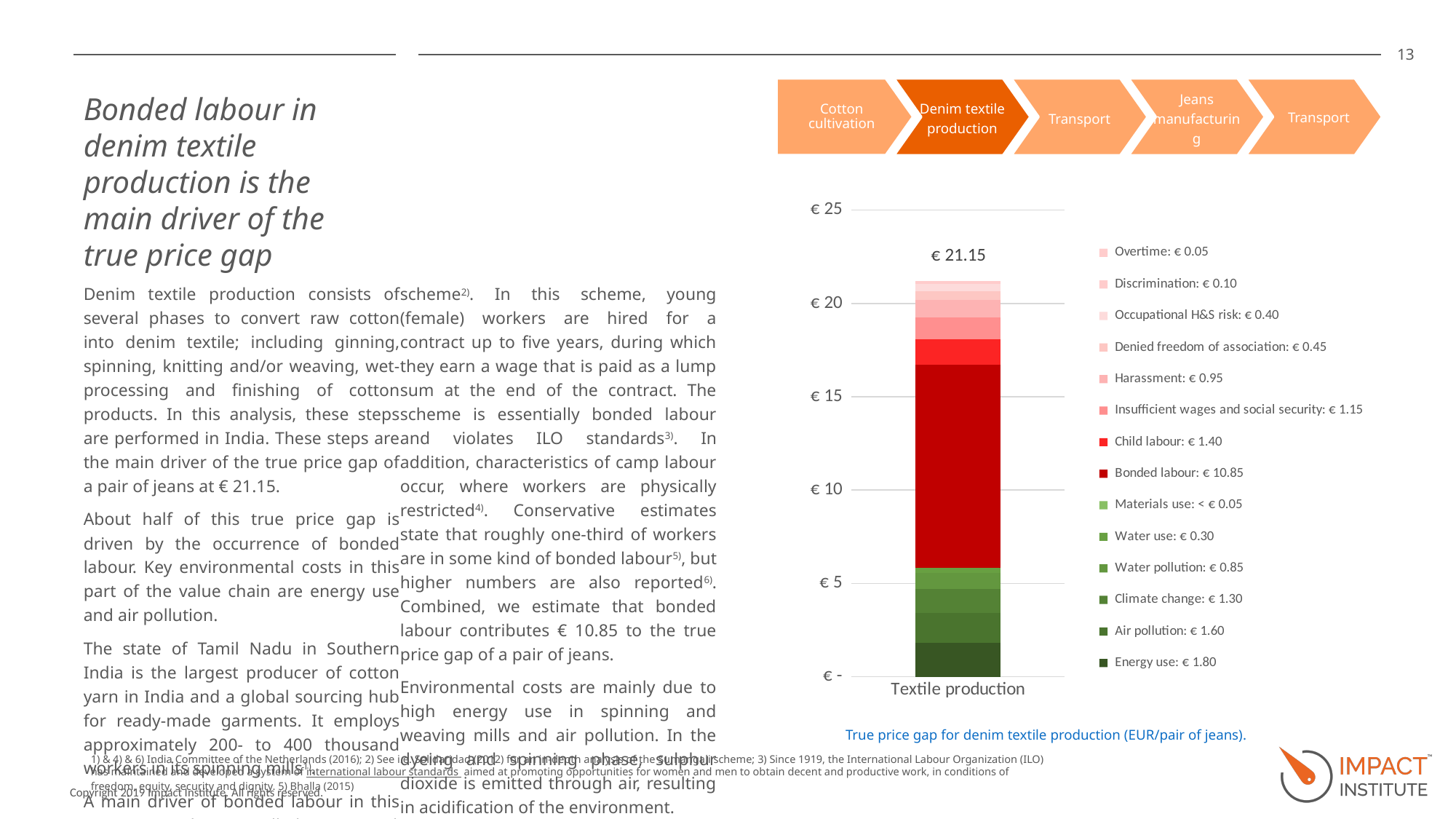
What is the value for Bonded labour in the legend? € 10.85 What is the value for Energy use? € 1.80 What is the value for Child labour? € 1.40 What kind of chart is shown on the slide? Stacked bar chart What is the total value of the stacked bar for Textile production? € 21.15 Is the total of the stacked bar greater or less than € 20? greater What is the difference between Bonded labour and Child labour? € 9.45 How many series does the legend list? 14 Which is larger, Air pollution or Climate change? Air pollution What is the difference between Energy use and Air pollution? € 0.20 Which component contributes the largest amount to the true price gap? Bonded labour What is the category label on the x axis of the chart? Textile production